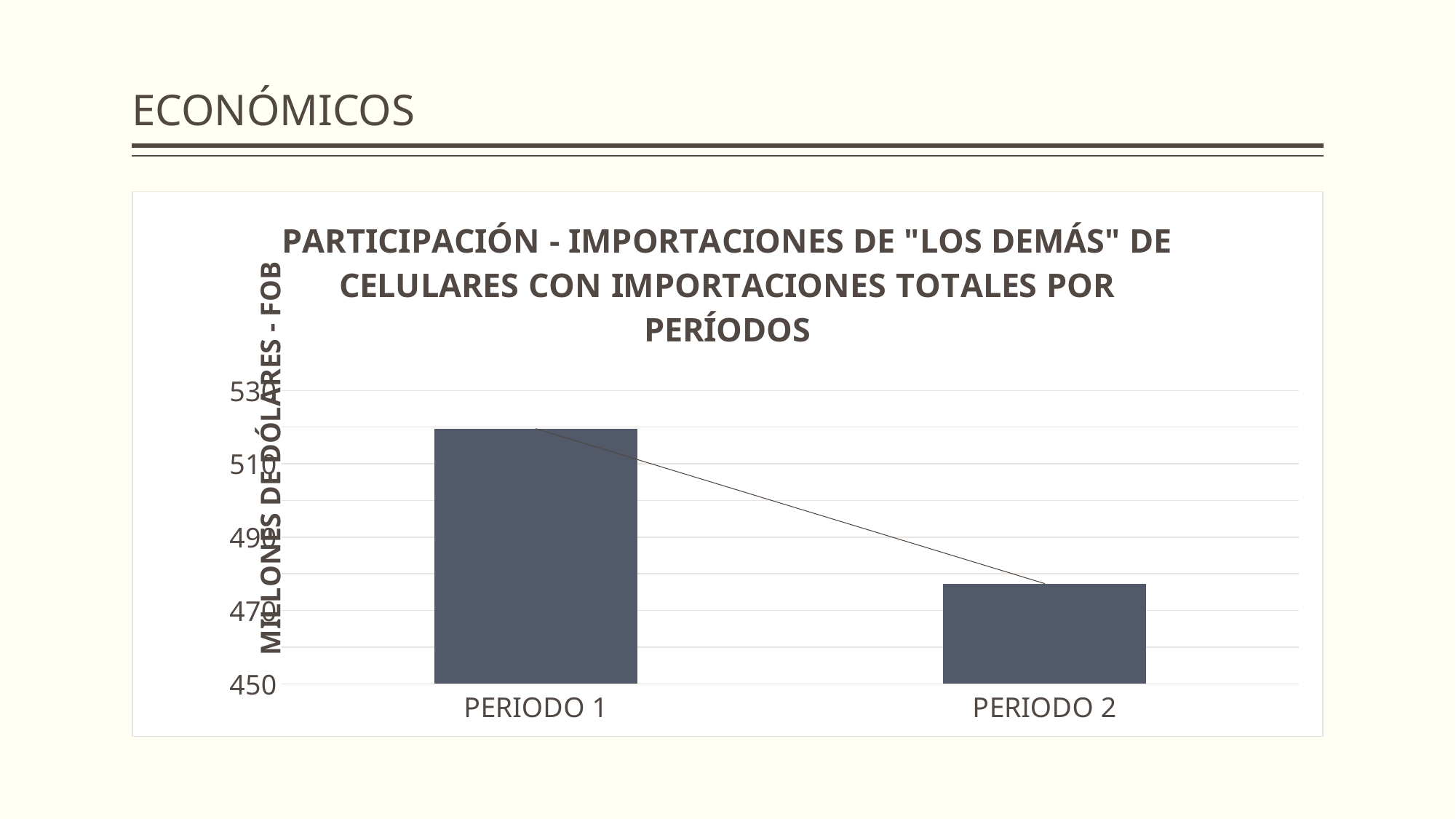
What kind of chart is shown on the slide? Bar chart Which is larger, the value for PERIODO 1 or the value for PERIODO 2? PERIODO 1 Which period has the lowest value in the chart? PERIODO 2 Do the values rise or fall from PERIODO 1 to PERIODO 2? Fall What is the lowest value shown on the vertical axis of the chart? 450 Is the value for PERIODO 2 greater or less than 470? greater How many categories are plotted on the x axis of the chart? 2 Is the value for PERIODO 1 greater or less than 530? less Is the value for PERIODO 2 greater or less than 490? less What is the label of the vertical axis of the chart? MILLONES DE DÓLARES - FOB Which period has the highest value in the chart? PERIODO 1